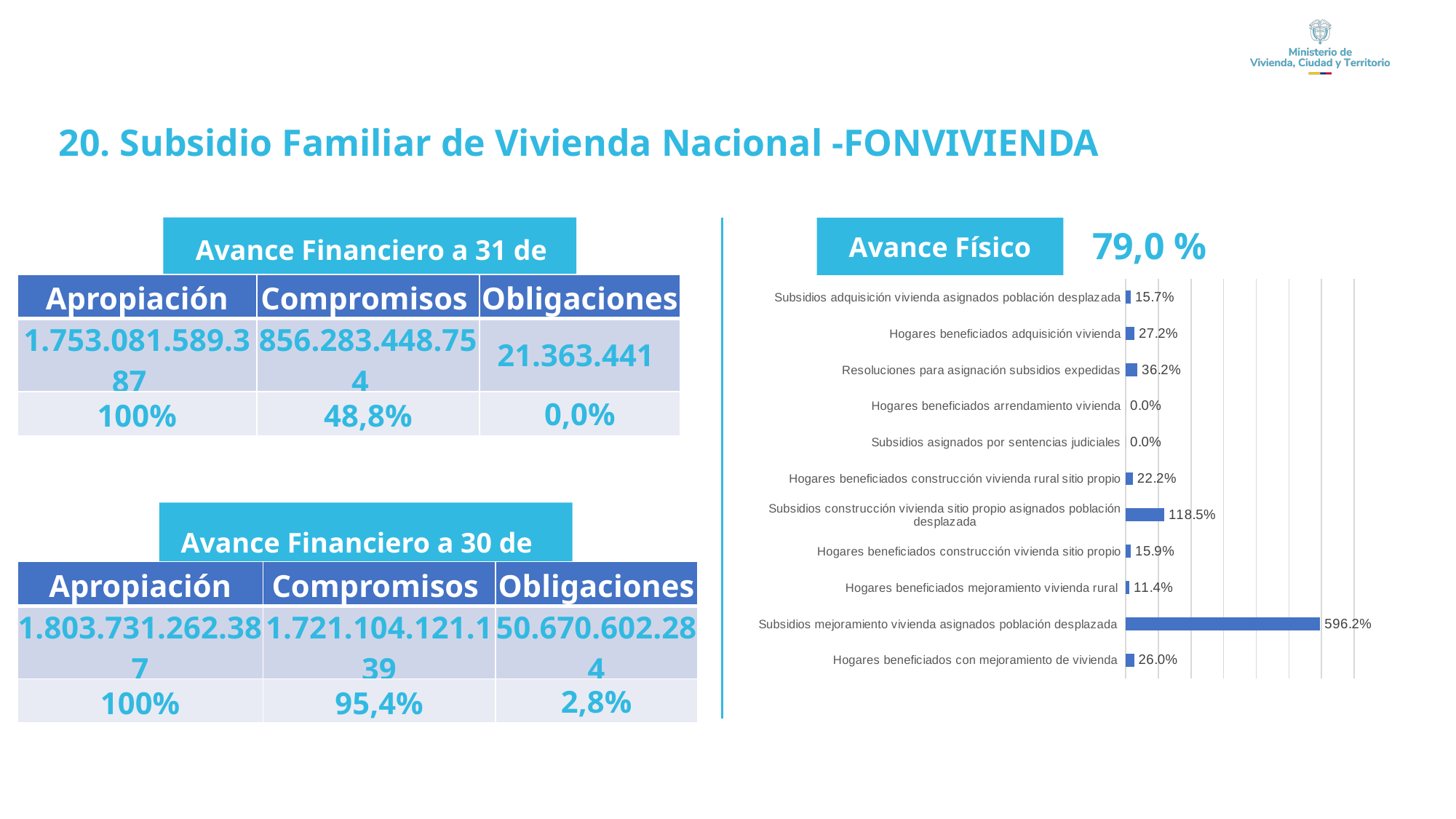
What is the value for "Subsidios mejoramiento vivienda asignados población desplazada"? 596.2% What is the value for "Resoluciones para asignación subsidios expedidas"? 36.2% What overall percentage is shown next to the "Avance Físico" heading above the chart? 79,0 % What is the difference between the values for "Subsidios mejoramiento vivienda asignados población desplazada" and "Subsidios construcción vivienda sitio propio asignados población desplazada"? 477.7% What is the difference between the values for "Resoluciones para asignación subsidios expedidas" and "Hogares beneficiados adquisición vivienda"? 9.0% What kind of chart is shown under the "Avance Físico" heading? bar chart How many categories are plotted in the bar chart? 11 How many categories in the bar chart have a value of 0.0%? 2 Which category has the highest value in the bar chart? Subsidios mejoramiento vivienda asignados población desplazada Which is larger: the value for "Hogares beneficiados adquisición vivienda" or for "Hogares beneficiados construcción vivienda rural sitio propio"? Hogares beneficiados adquisición vivienda What is the value for "Subsidios construcción vivienda sitio propio asignados población desplazada"? 118.5% What is the value for "Hogares beneficiados mejoramiento vivienda rural"? 11.4%